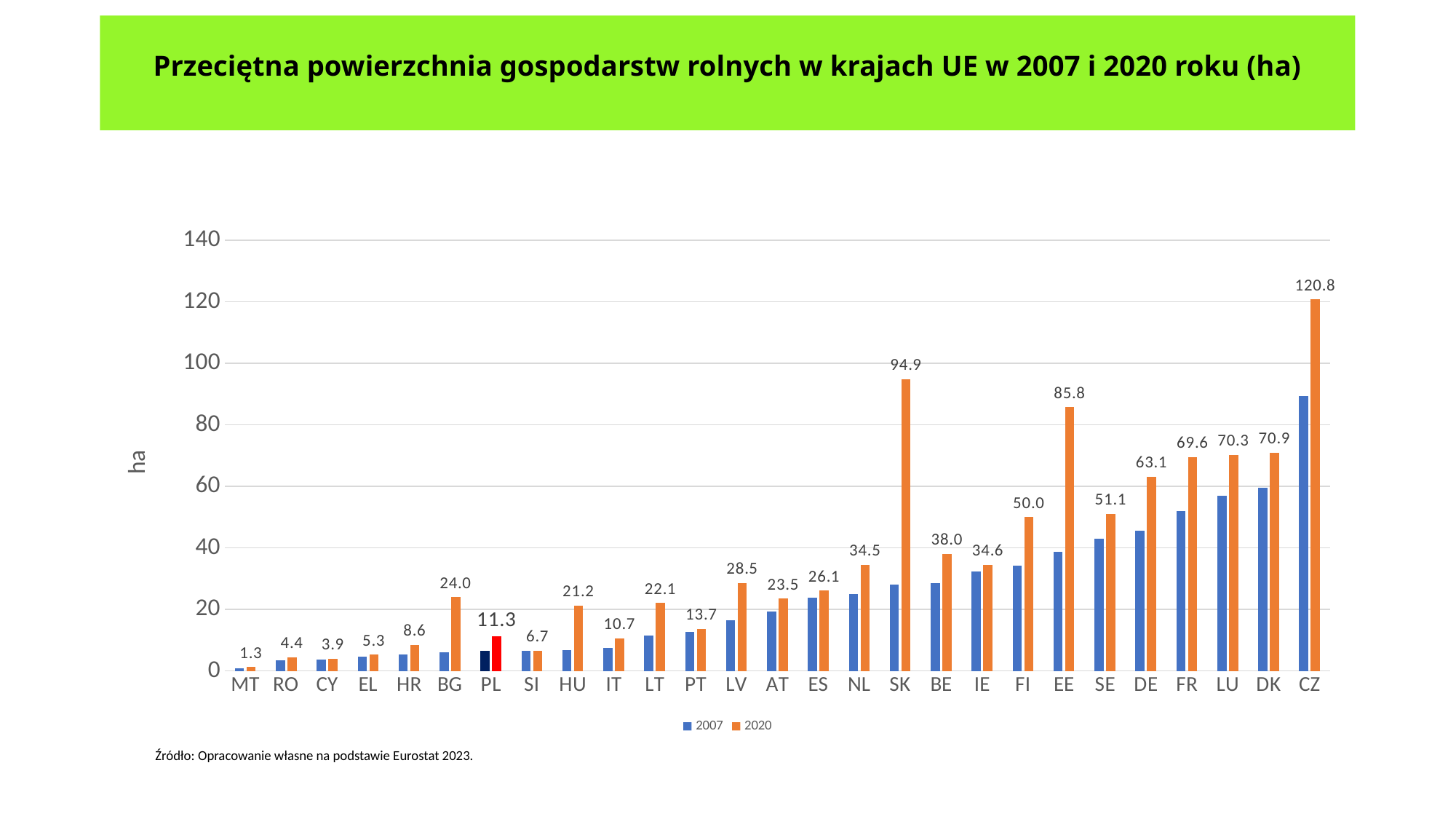
What is the 2020 value for SK? 94.9 Which country has the lowest 2020 value? MT Which colour represents the 2020 series in the legend? orange What kind of chart is shown on the slide? bar chart What is the difference between the 2020 values for CZ and SK? 25.9 How many series does the legend list? 2 Which has the larger 2020 value, EE or FI? EE Is the 2007 value for CZ greater or less than 80? greater How many countries are shown on the x axis? 27 Do the 2020 values rise or fall from left to right along the x axis? rise What is the 2020 value for PL? 11.3 Which country has the highest 2020 value? CZ